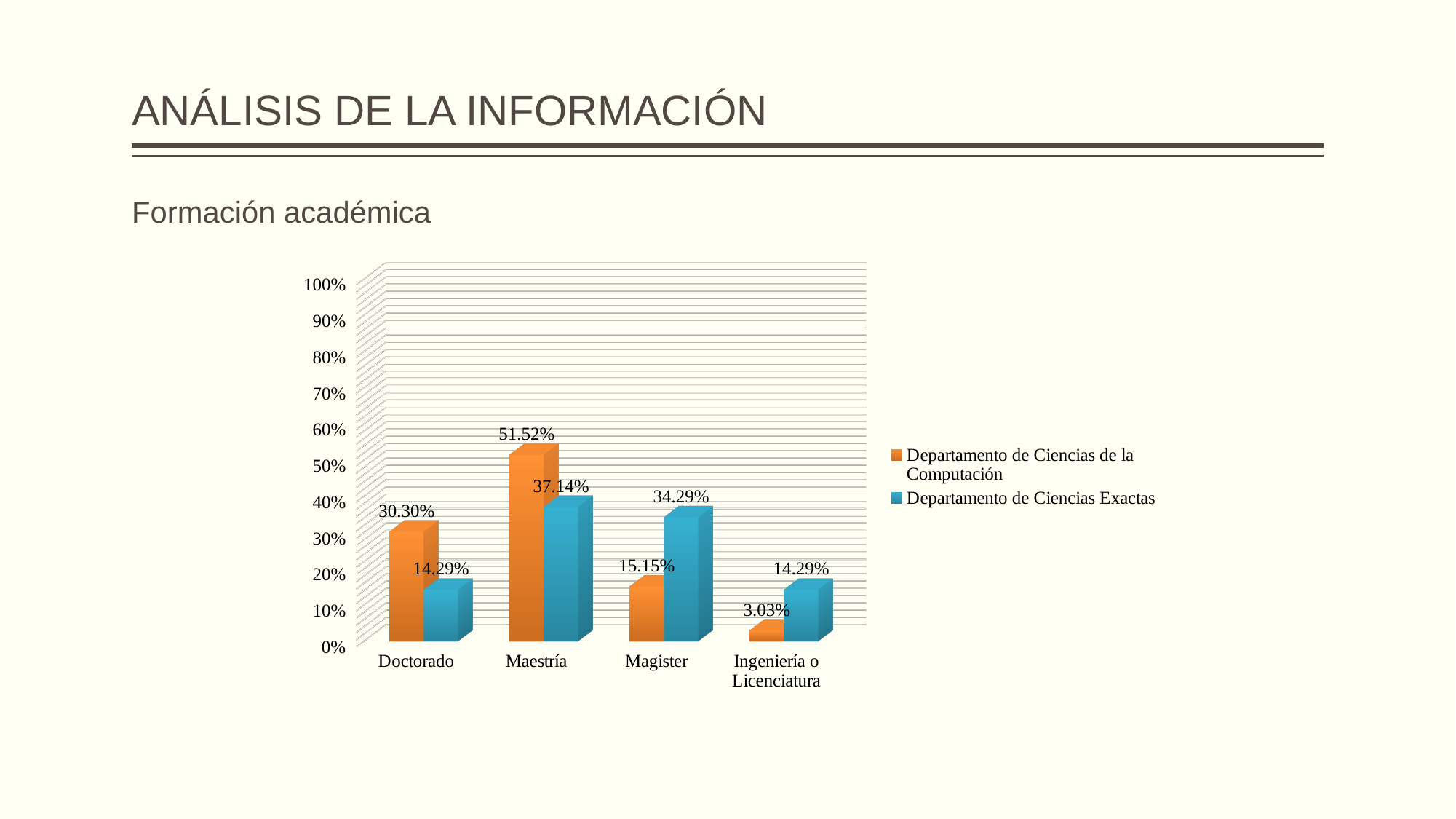
What is the value for Maestría in the Departamento de Ciencias Exactas series? 37.14% What kind of chart is shown on the slide? Bar chart What is the value for Doctorado in the Departamento de Ciencias de la Computación series? 30.30% For Magister, which series has the larger value? Departamento de Ciencias Exactas What is the value for Ingeniería o Licenciatura in the Departamento de Ciencias de la Computación series? 3.03% Which category has the lowest value in the Departamento de Ciencias Exactas series? Doctorado and Ingeniería o Licenciatura (both 14.29%) What is the difference between the two series' values for Maestría? 14.38% What colour represents the Departamento de Ciencias Exactas series? Blue How many categories are shown on the x axis? 4 How many series does the legend list? 2 Which category has the highest value in the Departamento de Ciencias de la Computación series? Maestría Is the value for Magister in the Departamento de Ciencias de la Computación series greater or less than 20%? less